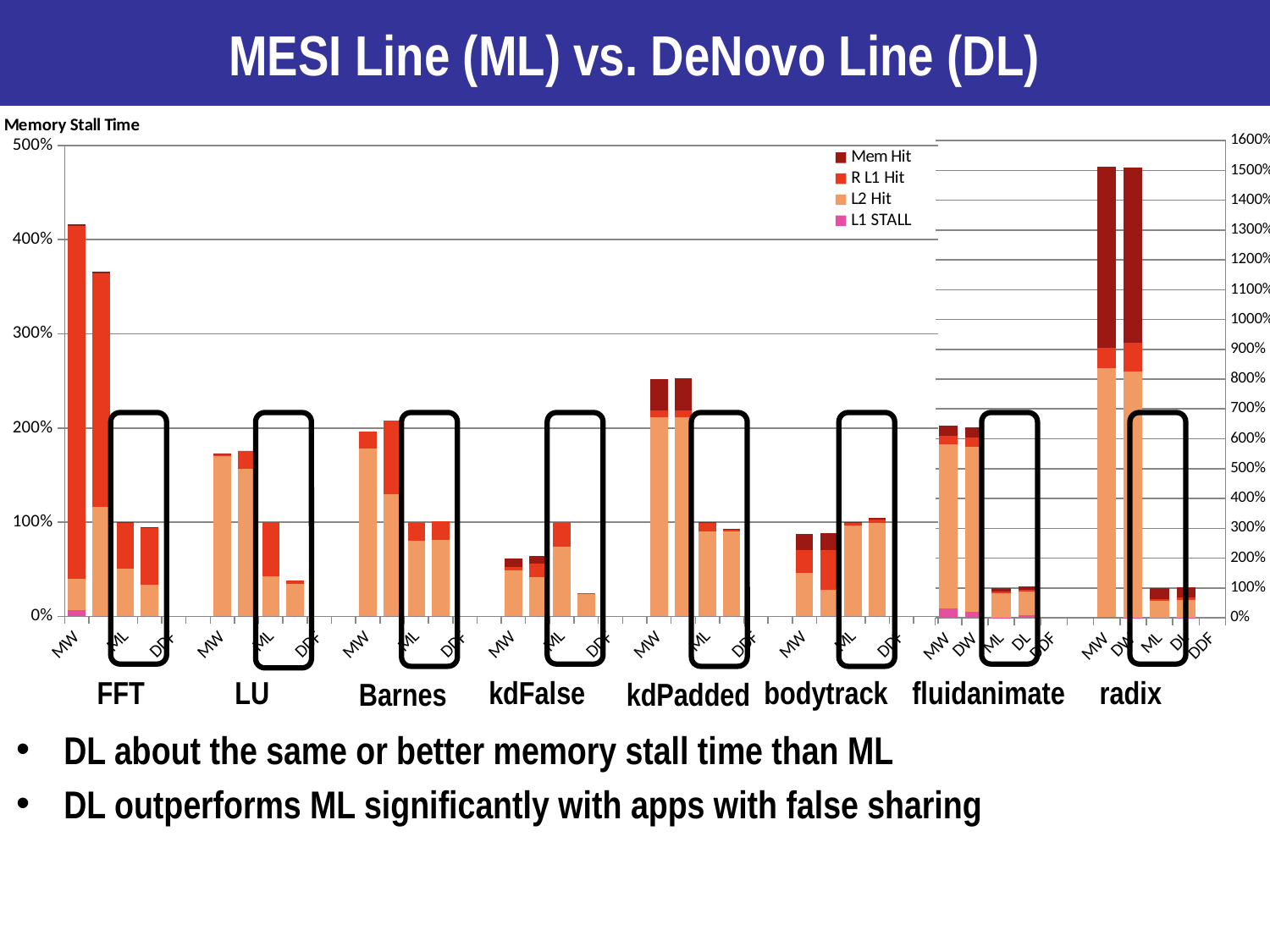
Which is larger, the FFT MW bar or the FFT ML bar? FFT MW Which series is listed first in the legend? Mem Hit Is the value for the FFT MW bar greater or less than 400% on the left axis? greater How many series does the legend list? 4 Is the value for the kdFalse MW bar greater or less than 100% on the left axis? less What is the title of the chart? Memory Stall Time Is the value for the kdPadded MW bar greater or less than 200% on the left axis? greater How many application groups are shown along the x axis? 8 What kind of chart is shown on the slide? stacked bar chart